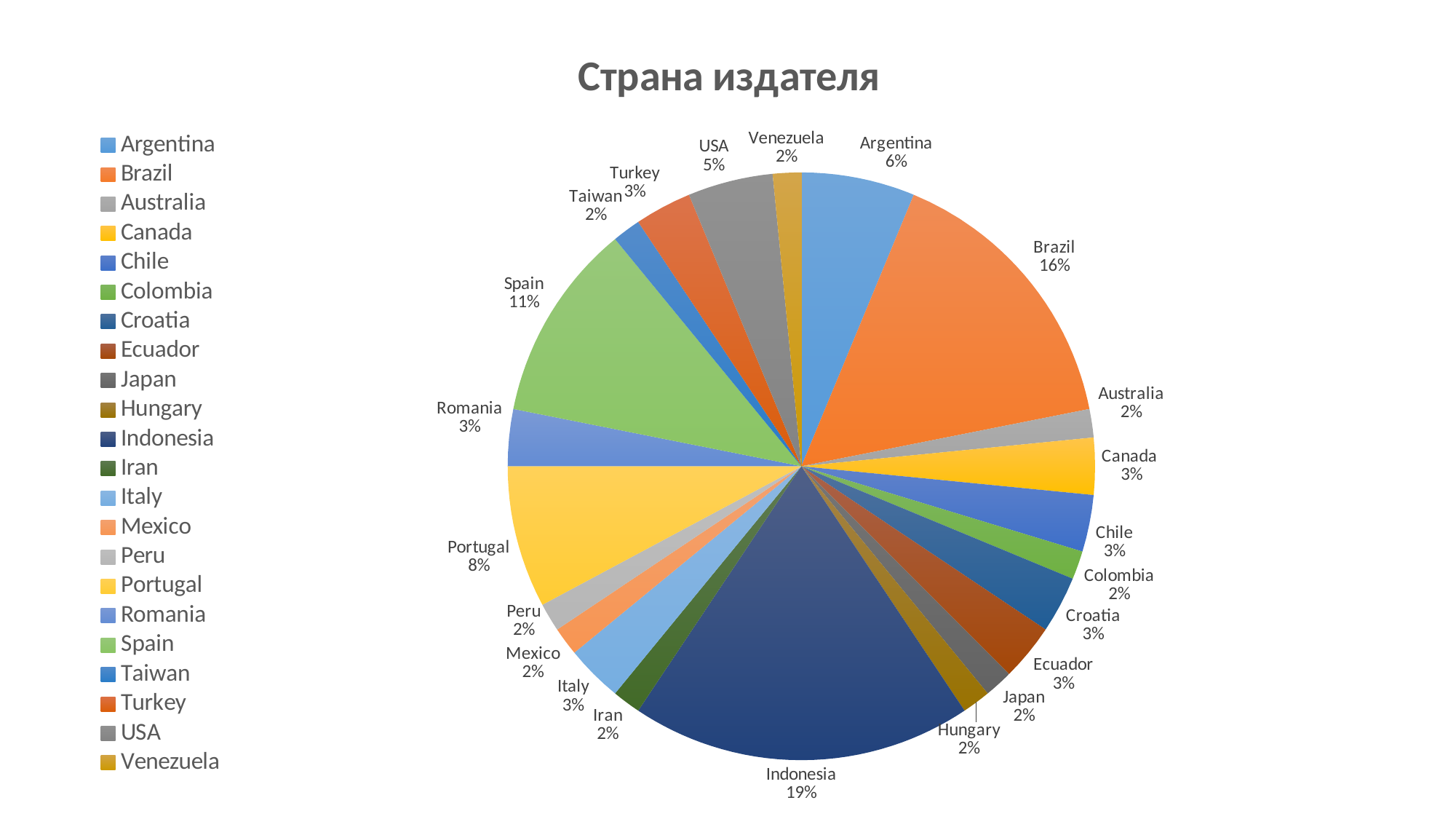
What share of the pie does Indonesia have? 19% What is the difference between the shares of Indonesia and Brazil? 3% How many countries are shown in the pie chart? 22 What is the value shown for Portugal? 8% What is the value shown for Brazil? 16% What is the value shown for USA? 5% What kind of chart is shown on the slide? pie chart Which country has the largest slice of the pie? Indonesia Which has a larger share, Spain or Portugal? Spain What is the difference between the shares of Argentina and Venezuela? 4% What is the title of the chart? Страна издателя What is the value shown for Spain? 11%